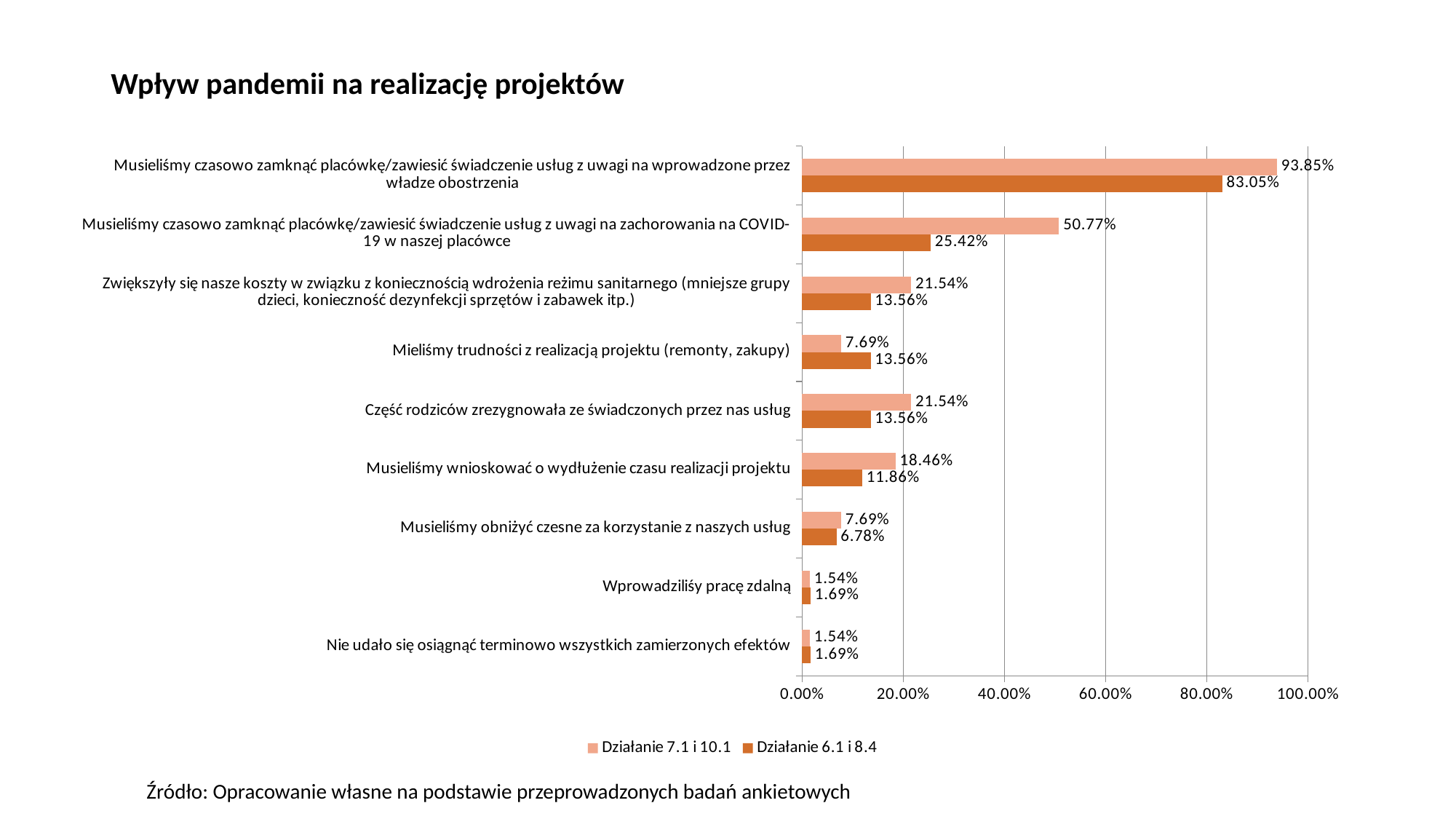
What is the title of the chart? Wpływ pandemii na realizację projektów How many series does the legend list? 2 Is the value for 'Działanie 6.1 i 8.4' for 'Musieliśmy czasowo zamknąć placówkę/zawiesić świadczenie usług z uwagi na wprowadzone przez władze obostrzenia' greater or less than 80.00%? greater What is the difference between the 'Działanie 7.1 i 10.1' and 'Działanie 6.1 i 8.4' values for 'Musieliśmy czasowo zamknąć placówkę/zawiesić świadczenie usług z uwagi na zachorowania na COVID-19 w naszej placówce'? 25.35% What is the value for 'Działanie 6.1 i 8.4' for 'Musieliśmy czasowo zamknąć placówkę/zawiesić świadczenie usług z uwagi na zachorowania na COVID-19 w naszej placówce'? 25.42% What is the value for 'Działanie 7.1 i 10.1' for 'Musieliśmy czasowo zamknąć placówkę/zawiesić świadczenie usług z uwagi na wprowadzone przez władze obostrzenia'? 93.85% How many categories are shown on the chart? 9 What is the value for 'Działanie 6.1 i 8.4' for 'Wprowadziliśy pracę zdalną'? 1.69% What is the value for 'Działanie 7.1 i 10.1' for 'Musieliśmy wnioskować o wydłużenie czasu realizacji projektu'? 18.46% Which category has the highest value for 'Działanie 6.1 i 8.4'? Musieliśmy czasowo zamknąć placówkę/zawiesić świadczenie usług z uwagi na wprowadzone przez władze obostrzenia What kind of chart is shown on the slide? bar chart For 'Mieliśmy trudności z realizacją projektu (remonty, zakupy)', which series has the larger value? Działanie 6.1 i 8.4